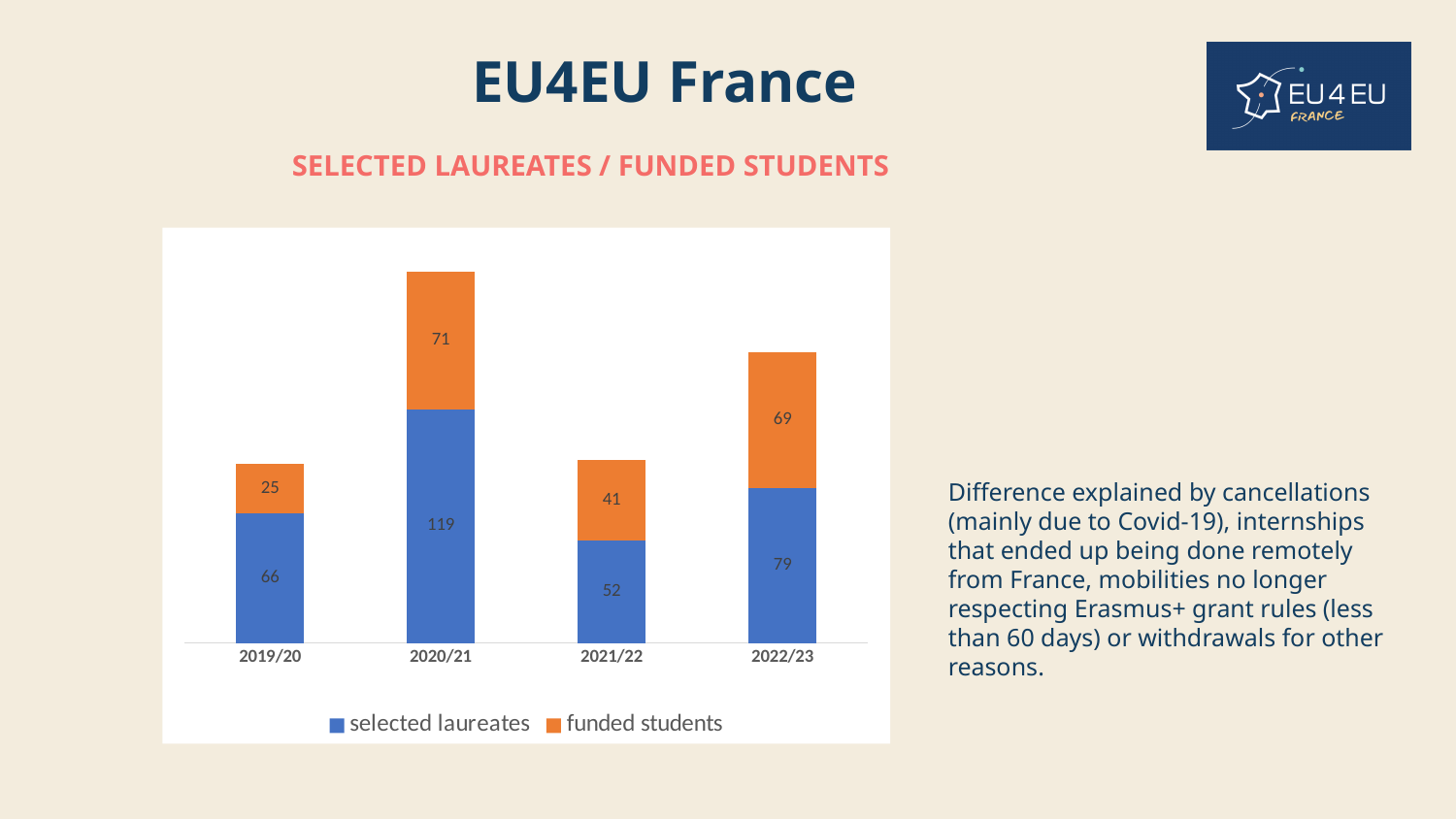
What is the value for selected laureates in 2020/21? 119 What is the value for funded students in 2022/23? 69 Which is larger: funded students in 2020/21 or funded students in 2022/23? funded students in 2020/21 Which year has the highest number of selected laureates? 2020/21 What kind of chart is shown on the slide? stacked bar chart What is the title of the chart? SELECTED LAUREATES / FUNDED STUDENTS What is the difference between selected laureates and funded students in 2021/22? 11 How many years are shown on the x axis? 4 What is the value for funded students in 2019/20? 25 How many series does the legend list? 2 What is the total of the stacked bar for 2022/23? 148 Which year has the lowest number of funded students? 2019/20